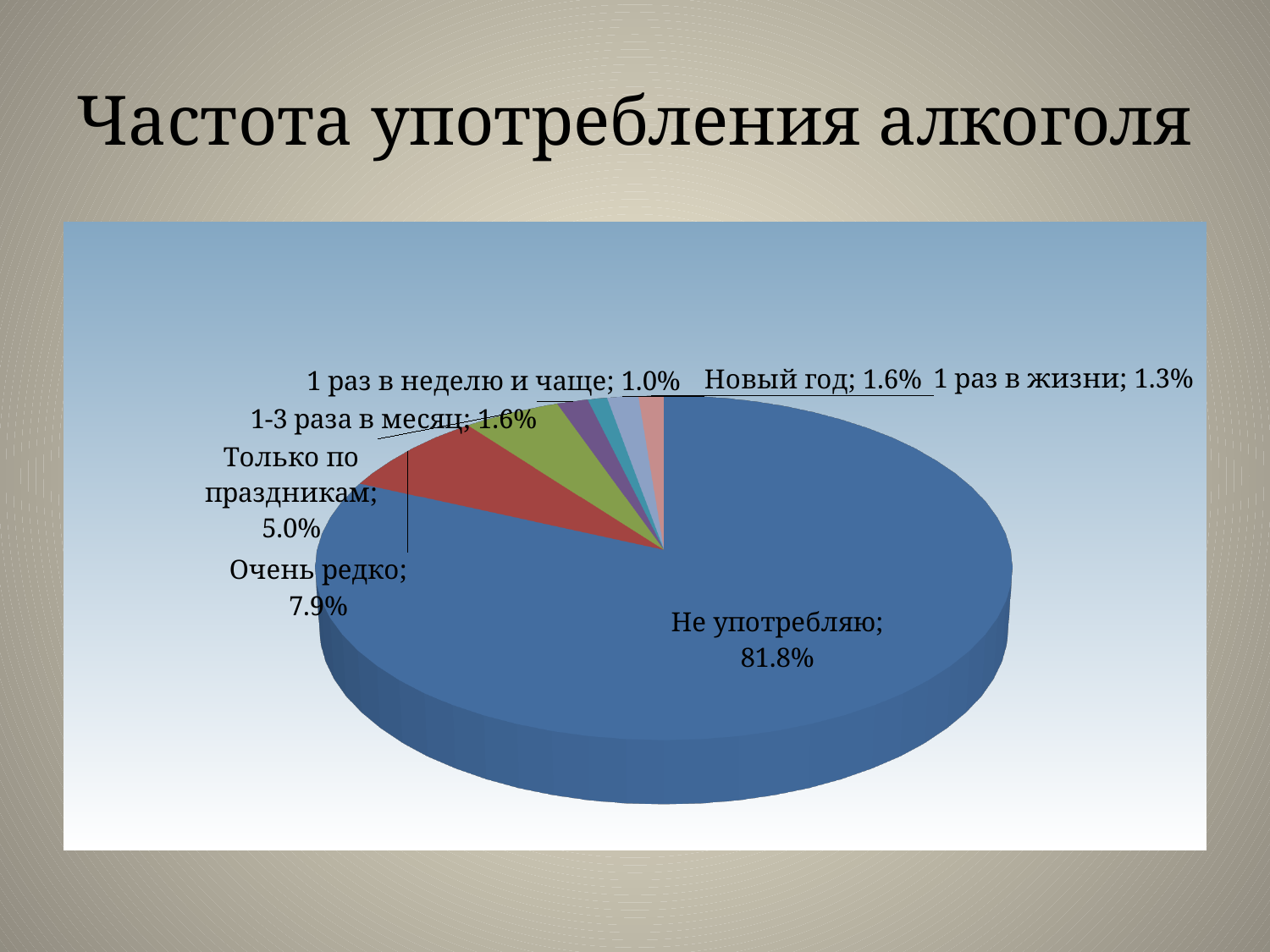
What percentage is shown for "1 раз в жизни"? 1.3% What is the difference between the shares for "Очень редко" and "Только по праздникам"? 2.9% What is the title of the chart on the slide? Частота употребления алкоголя What percentage is shown for "Не употребляю"? 81.8% Which is larger, the share for "Новый год" or the share for "1 раз в жизни"? Новый год How many categories (slices) does the pie chart have? 7 Which category has the largest share of the pie? Не употребляю What percentage is shown for "Только по праздникам"? 5.0% What percentage is shown for "1 раз в неделю и чаще"? 1.0% Which category has the smallest share of the pie? 1 раз в неделю и чаще What type of chart is shown on the slide? Pie chart What percentage is shown for "Очень редко"? 7.9%